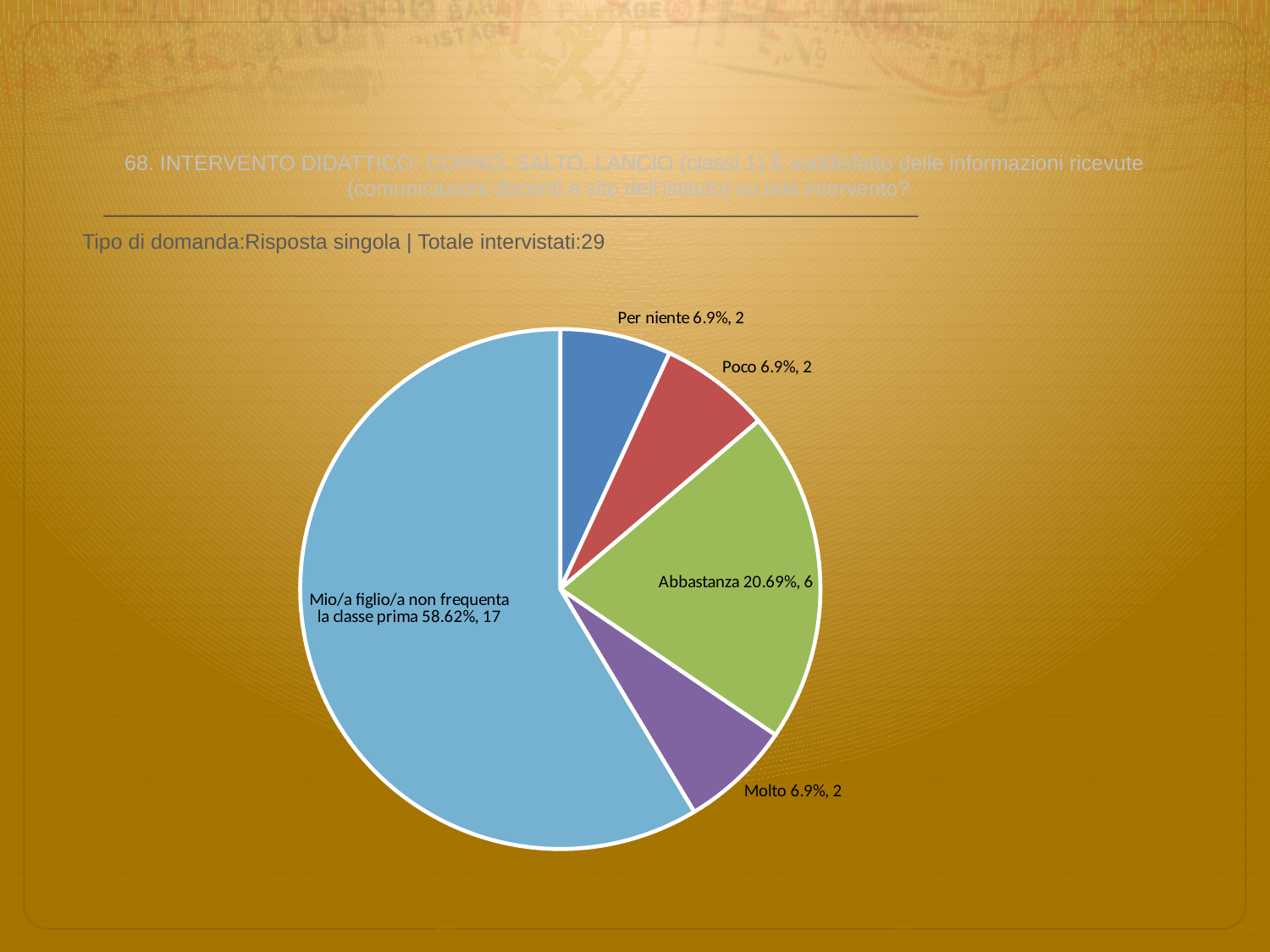
What is the difference in respondents between 'Mio/a figlio/a non frequenta la classe prima' and 'Abbastanza'? 11 What percentage share does the 'Mio/a figlio/a non frequenta la classe prima' slice have? 58.62% Which is larger, the 'Abbastanza' slice or the 'Per niente' slice? Abbastanza What is the total number of respondents stated on the slide? 29 How many respondents answered 'Poco'? 2 What percentage share does the 'Molto' slice have? 6.9% What percentage share does the 'Abbastanza' slice have? 20.69% Which category has the largest slice? Mio/a figlio/a non frequenta la classe prima How many respondents answered 'Abbastanza'? 6 How many respondents answered 'Mio/a figlio/a non frequenta la classe prima'? 17 How many slices does the pie chart have? 5 What kind of chart is shown on the slide? pie chart